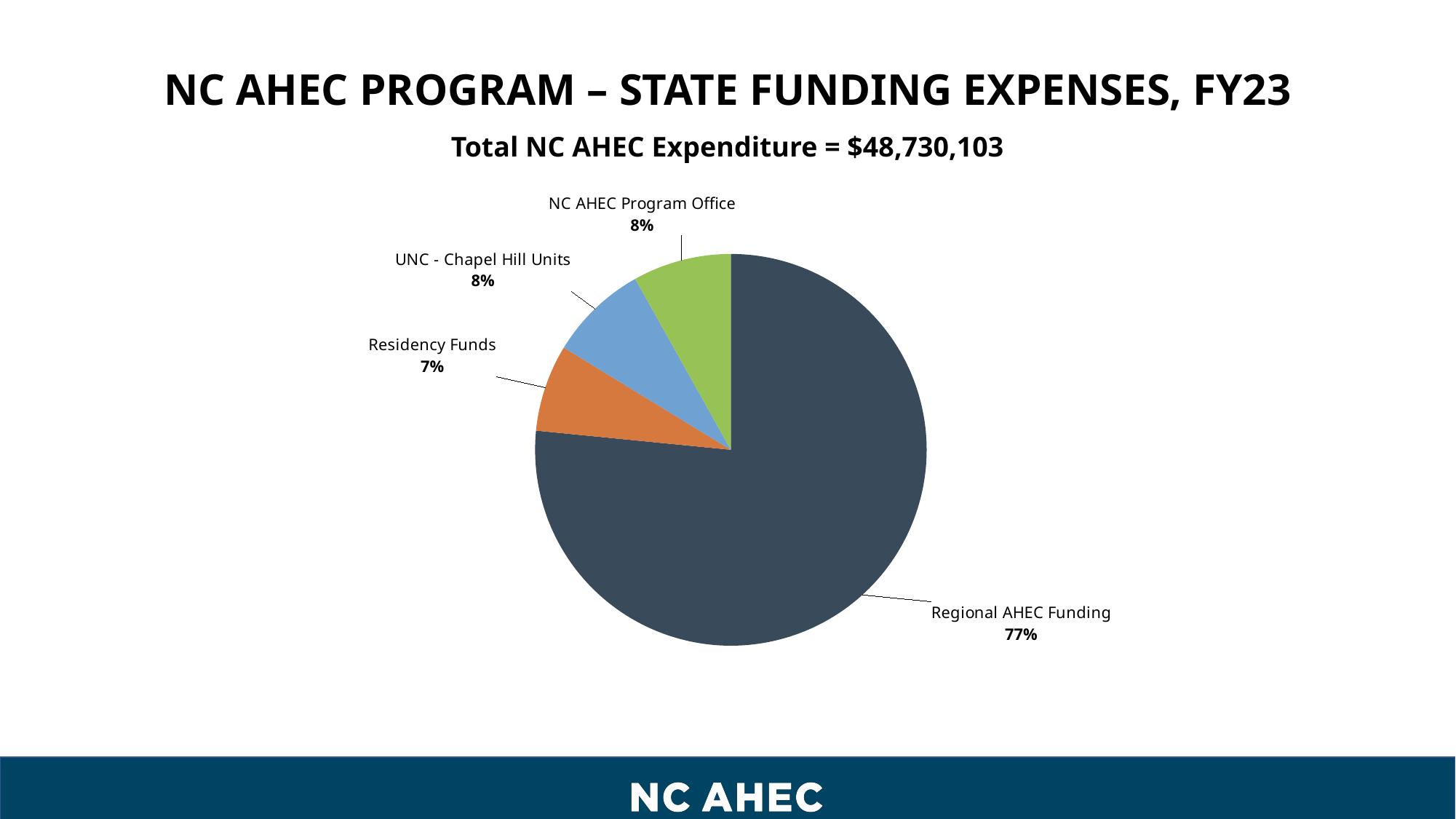
Which category has the smallest slice of the pie? Residency Funds What share of the pie does Regional AHEC Funding represent? 77% What is the total NC AHEC expenditure stated on the slide? $48,730,103 What percentage is shown for UNC - Chapel Hill Units? 8% What kind of chart is shown on the slide? Pie chart Which category has the largest slice of the pie? Regional AHEC Funding What percentage is shown for Residency Funds? 7% What is the difference in percentage points between Regional AHEC Funding and Residency Funds? 70 What percentage is shown for NC AHEC Program Office? 8% Which is larger, the share for Regional AHEC Funding or the share for NC AHEC Program Office? Regional AHEC Funding What colour is the Regional AHEC Funding slice? Dark blue-grey How many categories are shown in the pie chart? 4